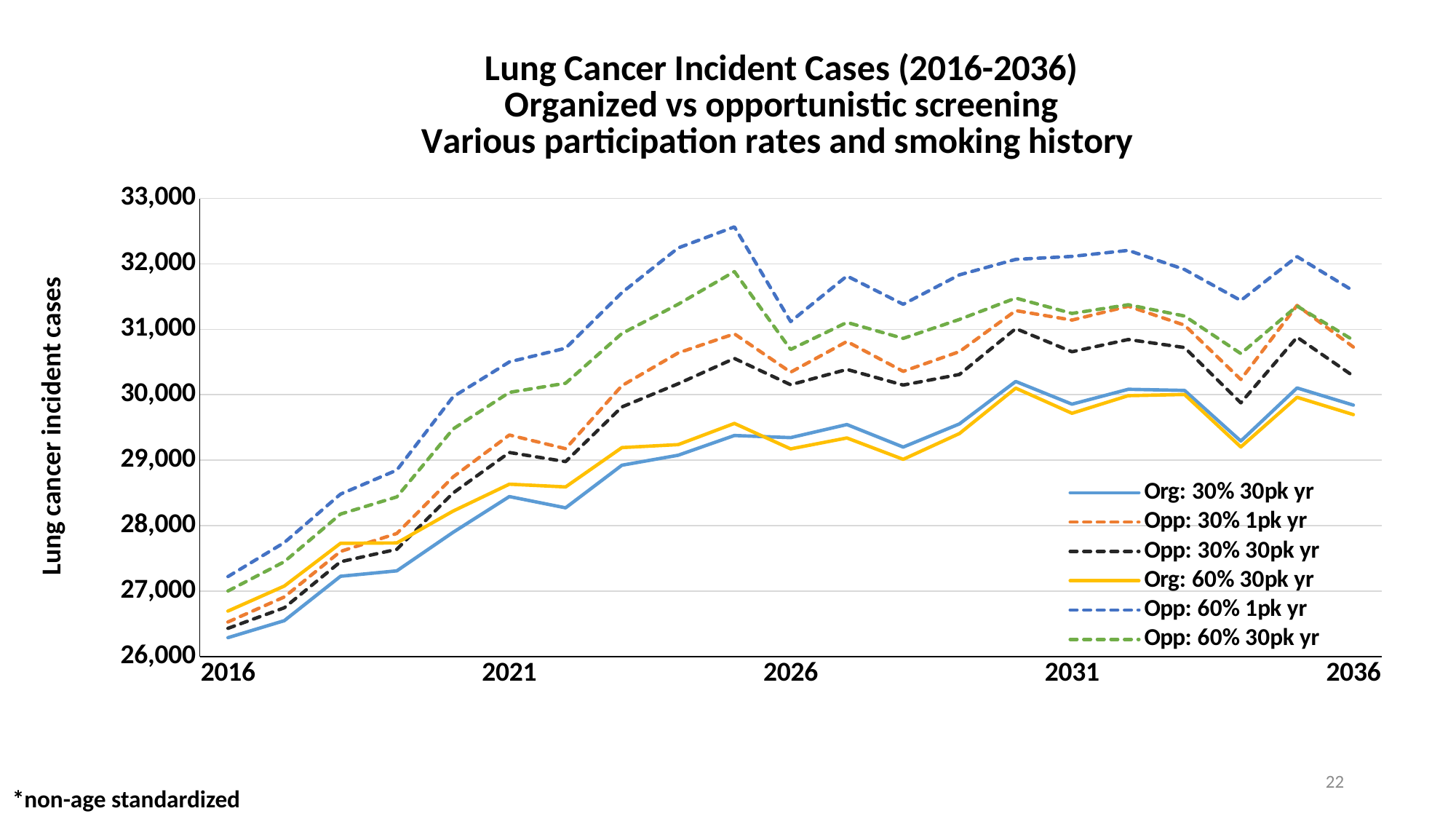
Is the value for Org: 60% 30pk yr in 2036 greater or less than 30,000? less Which series has the lowest value in 2016? Org: 30% 30pk yr Is the value for Opp: 60% 1pk yr in 2025 greater or less than 32,000? greater How many series does the legend list? 6 In 2026, which series has the larger value: Opp: 60% 1pk yr or Org: 60% 30pk yr? Opp: 60% 1pk yr Is the value for Opp: 30% 1pk yr in 2036 greater or less than 30,000? greater What is the label of the y axis? Lung cancer incident cases Do the values generally rise or fall from 2016 to 2036? rise What type of chart is shown on the slide? line chart How many years does the chart cover, from 2016 to 2036 inclusive? 21 Which series has the highest values across the chart? Opp: 60% 1pk yr